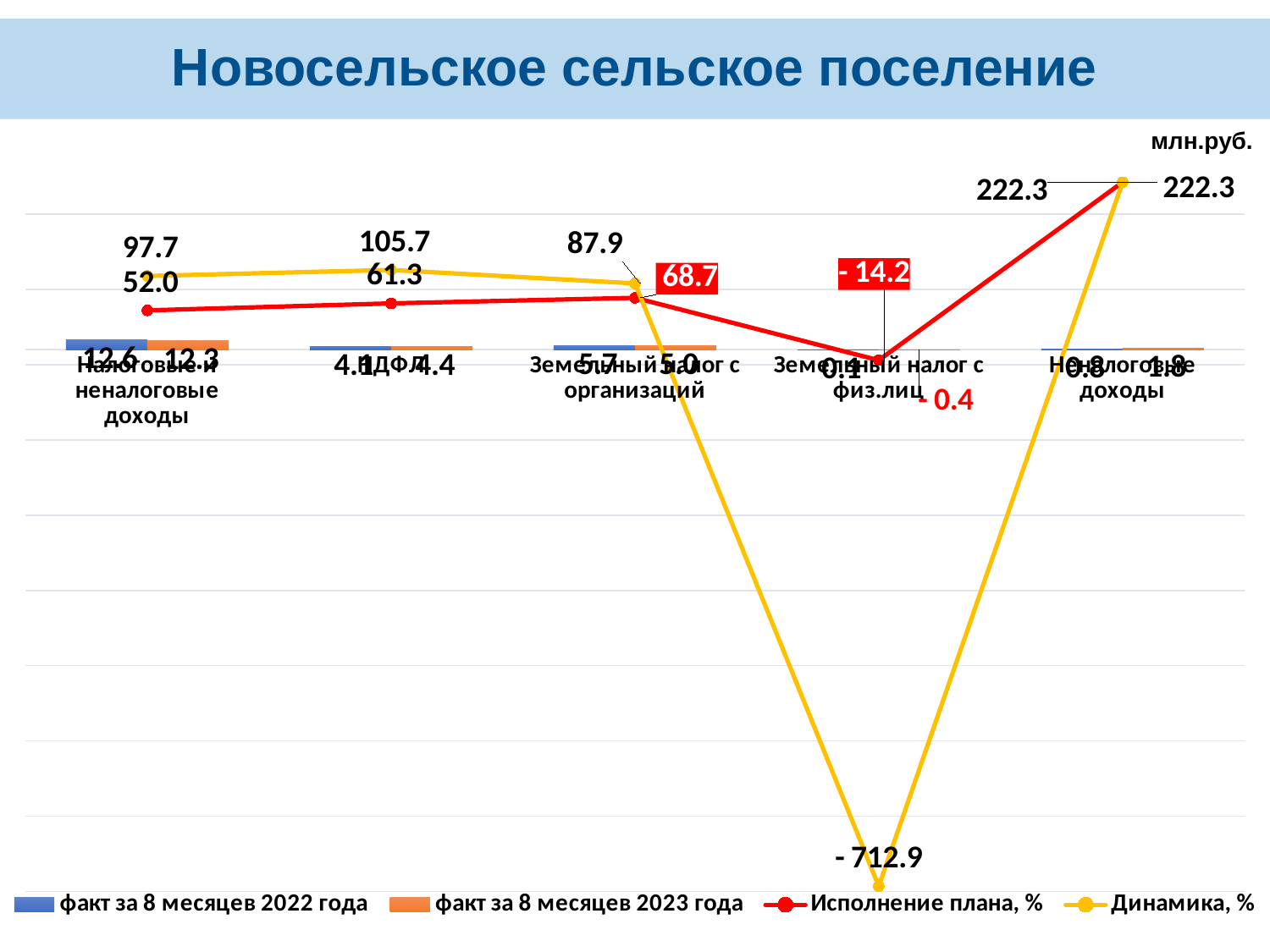
How many series does the legend list? 4 What is the value of 'факт за 8 месяцев 2022 года' for 'Налоговые и неналоговые доходы'? 12.6 How many categories are shown along the x axis? 5 Which category has the lowest value of 'Динамика, %'? Земельный налог с физ.лиц What is the value of 'Динамика, %' for 'Неналоговые доходы'? 222.3 What kind of chart is shown on the slide? A combined bar and line chart What is the value of 'Исполнение плана, %' for 'НДФЛ'? 61.3 For 'НДФЛ', which is larger: 'факт за 8 месяцев 2022 года' or 'факт за 8 месяцев 2023 года'? факт за 8 месяцев 2023 года What unit is indicated in the top right corner of the chart? млн.руб. Which category has the highest value of 'Исполнение плана, %'? Неналоговые доходы What is the value of 'Исполнение плана, %' for 'Земельный налог с физ.лиц'? - 14.2 What is the value of 'Динамика, %' for 'Земельный налог с физ.лиц'? - 712.9